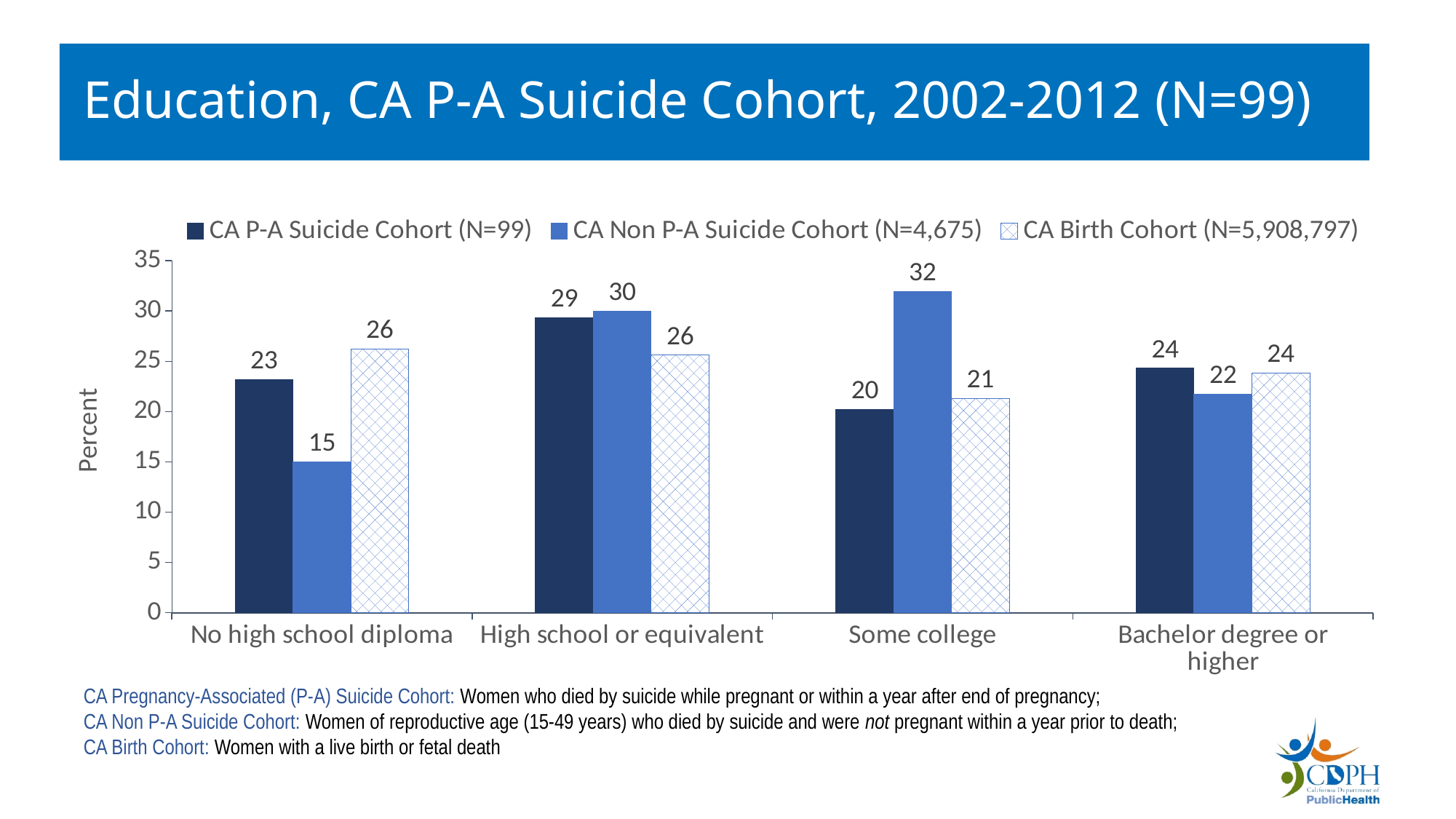
What is the value for the CA Non P-A Suicide Cohort in the Some college category? 32 What is the value for the CA P-A Suicide Cohort in the No high school diploma category? 23 What kind of chart is shown on the slide? Bar chart Which education category has the lowest value for the CA Non P-A Suicide Cohort? No high school diploma How many series does the legend list? 3 In the Some college category, which is larger: the CA P-A Suicide Cohort value or the CA Non P-A Suicide Cohort value? CA Non P-A Suicide Cohort How many education categories are shown on the x axis? 4 Is the value for the CA Non P-A Suicide Cohort in the Some college category greater or less than 30? greater What is the difference between the CA Birth Cohort and the CA Non P-A Suicide Cohort values in the No high school diploma category? 11 What is the label of the y axis? Percent What is the value for the CA Birth Cohort in the High school or equivalent category? 26 Which education category has the highest value for the CA P-A Suicide Cohort? High school or equivalent